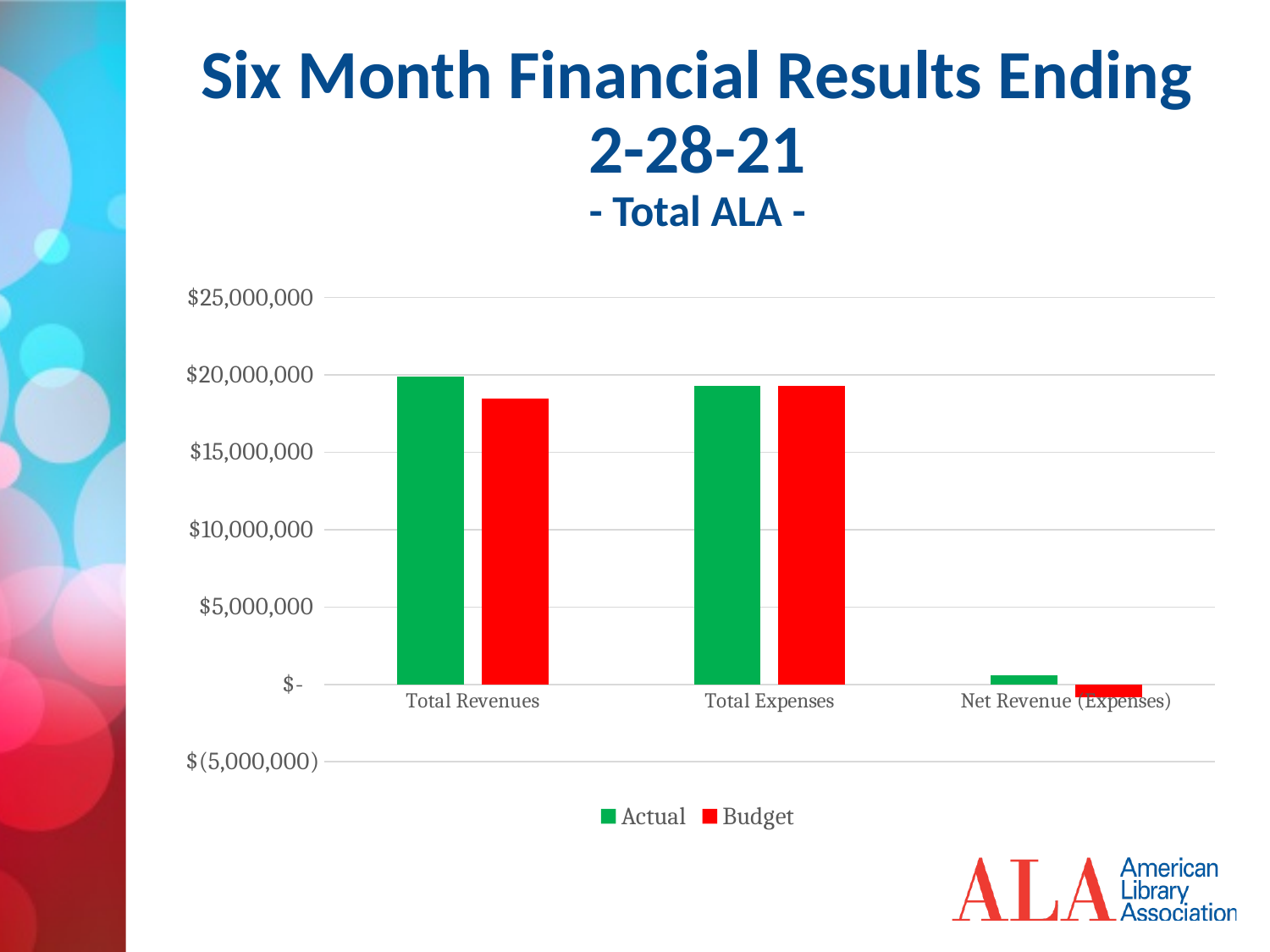
Is the Actual value for Net Revenue (Expenses) greater or less than $5,000,000? less Which category has the highest Actual value? Total Revenues What is the subtitle shown under the chart title date? - Total ALA - Is the Budget value for Total Expenses greater or less than $15,000,000? greater Is the Actual value for Total Revenues greater or less than $15,000,000? greater What kind of chart is shown on the slide? bar chart Which category has the lowest Actual value? Net Revenue (Expenses) How many series does the legend list? 2 For Total Revenues, which is larger, Actual or Budget? Actual How many categories are shown on the x axis? 3 Which series is shown in green? Actual